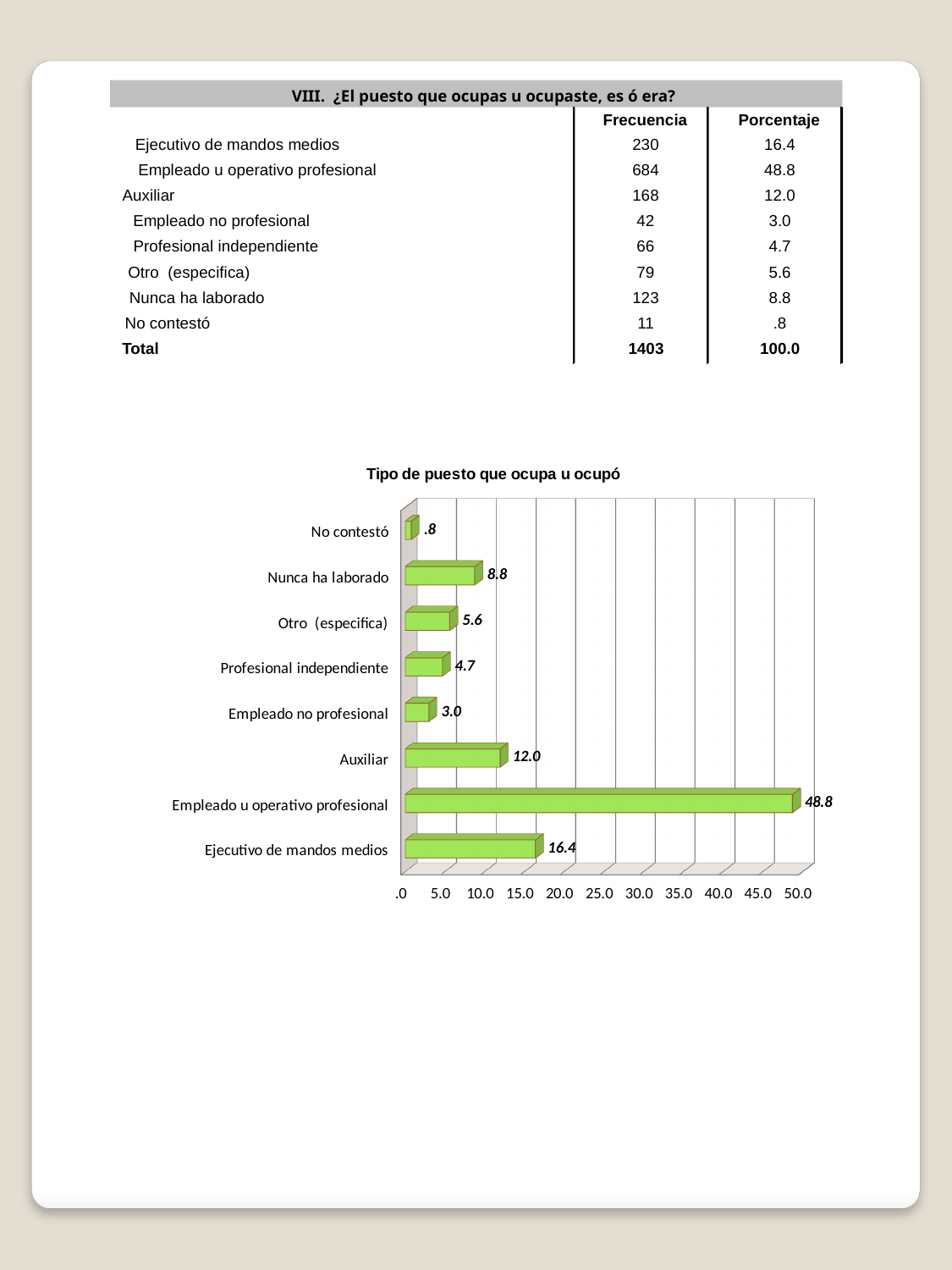
Which category has the lowest value in the chart? No contestó What is the value for Nunca ha laborado in the chart? 8.8 What is the difference between the values for Auxiliar and Nunca ha laborado? 3.2 Which is larger, the value for Otro (especifica) or the value for Profesional independiente? Otro (especifica) What kind of chart is shown on the slide? bar chart Is the value for Ejecutivo de mandos medios greater or less than 15.0? greater How many categories are shown in the chart? 8 What is the value for Empleado u operativo profesional in the chart? 48.8 Which category has the highest value in the chart? Empleado u operativo profesional What is the title of the chart? Tipo de puesto que ocupa u ocupó What is the value for Auxiliar in the chart? 12.0 What is the difference between the values for Empleado u operativo profesional and Ejecutivo de mandos medios? 32.4